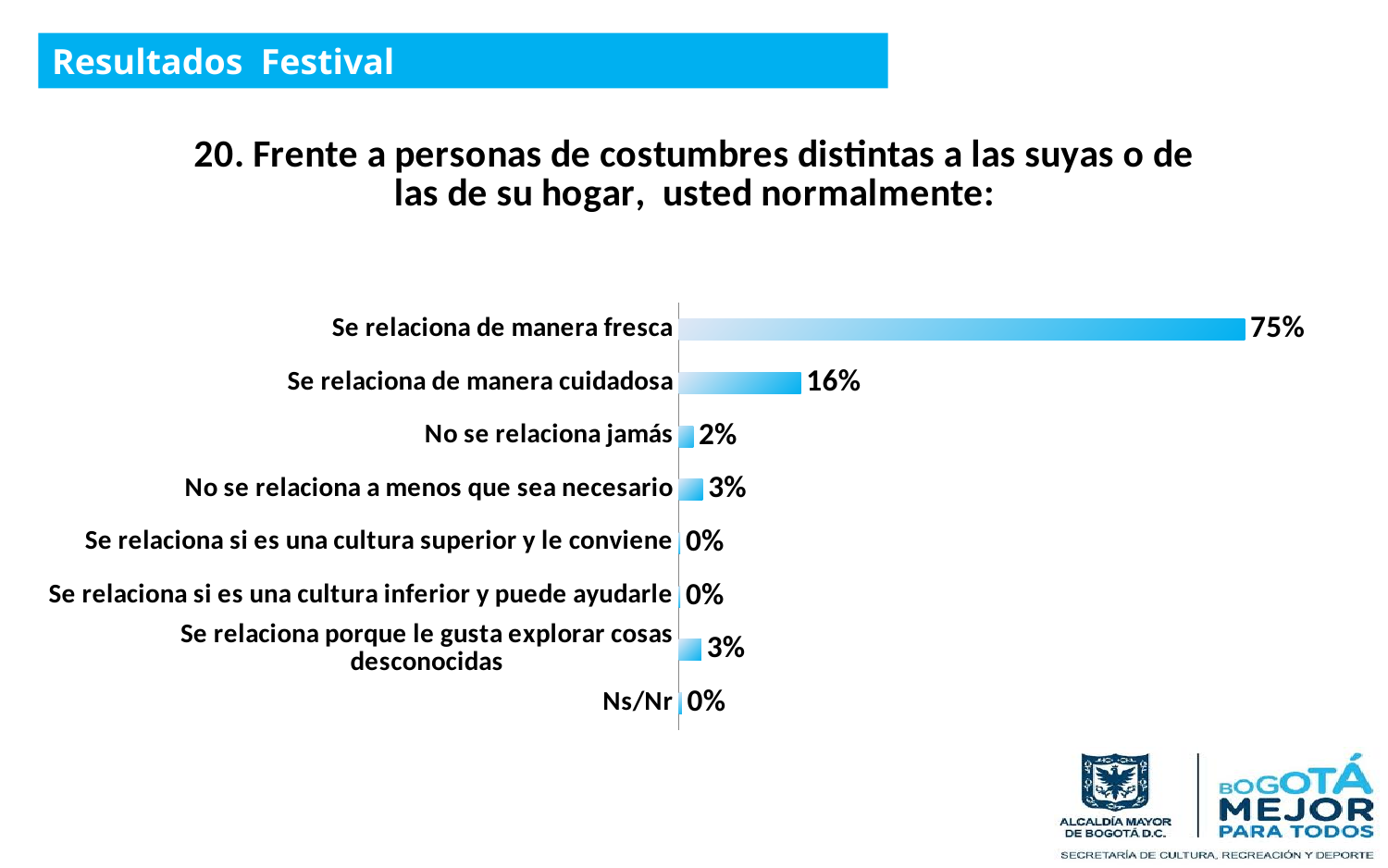
Which category has the highest value? Se relaciona de manera fresca Which is larger, "Se relaciona de manera cuidadosa" or "No se relaciona jamás"? Se relaciona de manera cuidadosa What is the value for "No se relaciona a menos que sea necesario"? 3% What is the difference between "Se relaciona de manera fresca" and "Se relaciona de manera cuidadosa"? 59% What is the value for "No se relaciona jamás"? 2% What is the value for "Se relaciona de manera cuidadosa"? 16% What is the value for "Ns/Nr"? 0% What is the value for "Se relaciona de manera fresca"? 75% How many categories have a value of 0%? 3 What kind of chart is shown on the slide? Bar chart What is the value for "Se relaciona porque le gusta explorar cosas desconocidas"? 3% How many categories are shown in the chart? 8